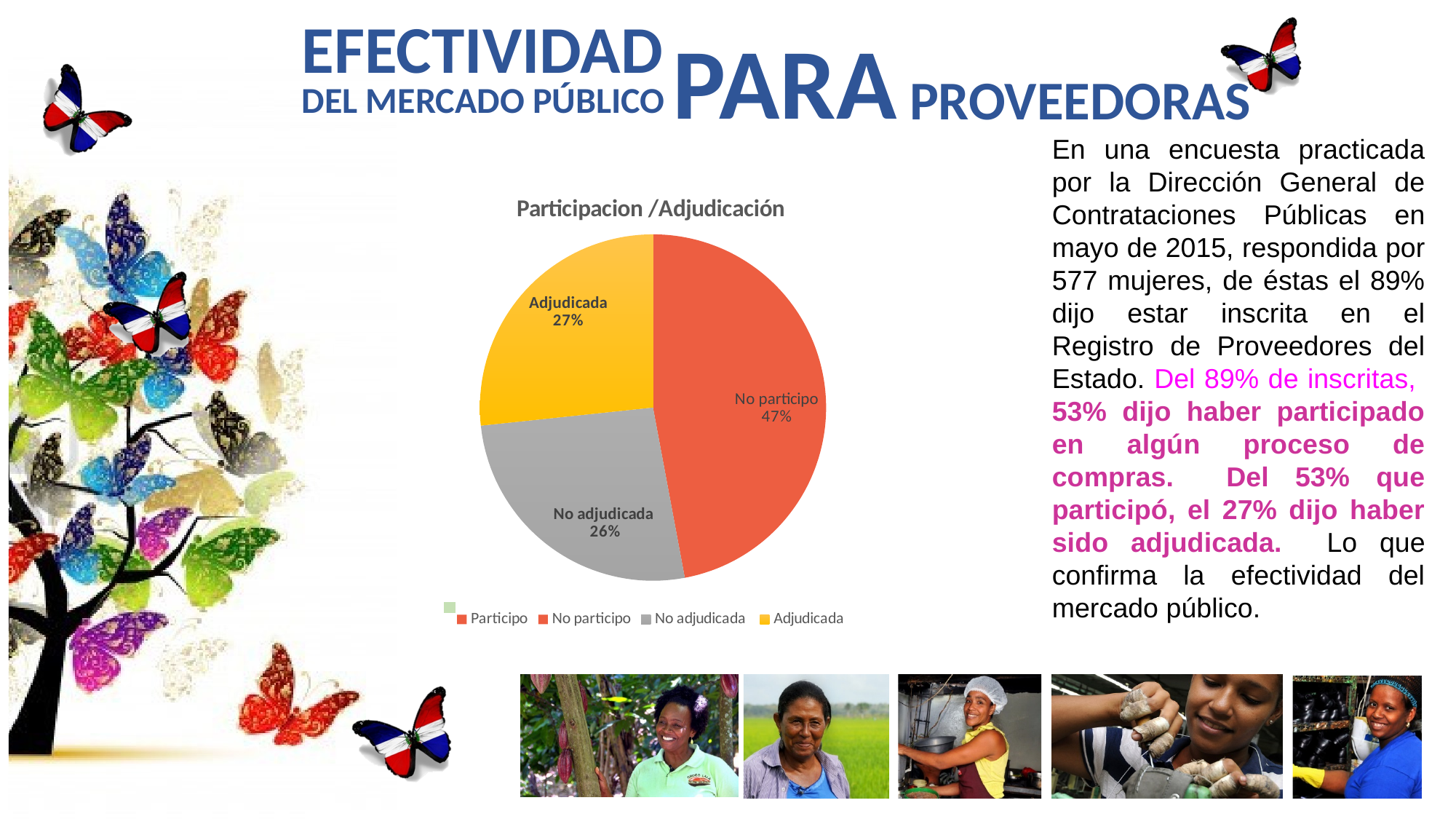
What kind of chart is shown on the slide? Pie chart What percentage of the pie chart is labelled "No participo"? 47% Which is larger in the pie chart, the "No participo" slice or the "Adjudicada" slice? No participo What is the title of the pie chart? Participacion /Adjudicación How many labelled slices does the pie chart have? 3 What percentage of the pie chart is labelled "Adjudicada"? 27% What is the difference in percentage points between the "No participo" slice and the "No adjudicada" slice? 21 percentage points Which slice of the pie chart is the smallest? No adjudicada What is the difference in percentage points between the "Adjudicada" slice and the "No adjudicada" slice? 1 percentage point What colour is the "Adjudicada" slice in the pie chart? Yellow What percentage of the pie chart is labelled "No adjudicada"? 26% Which slice of the pie chart is the largest? No participo